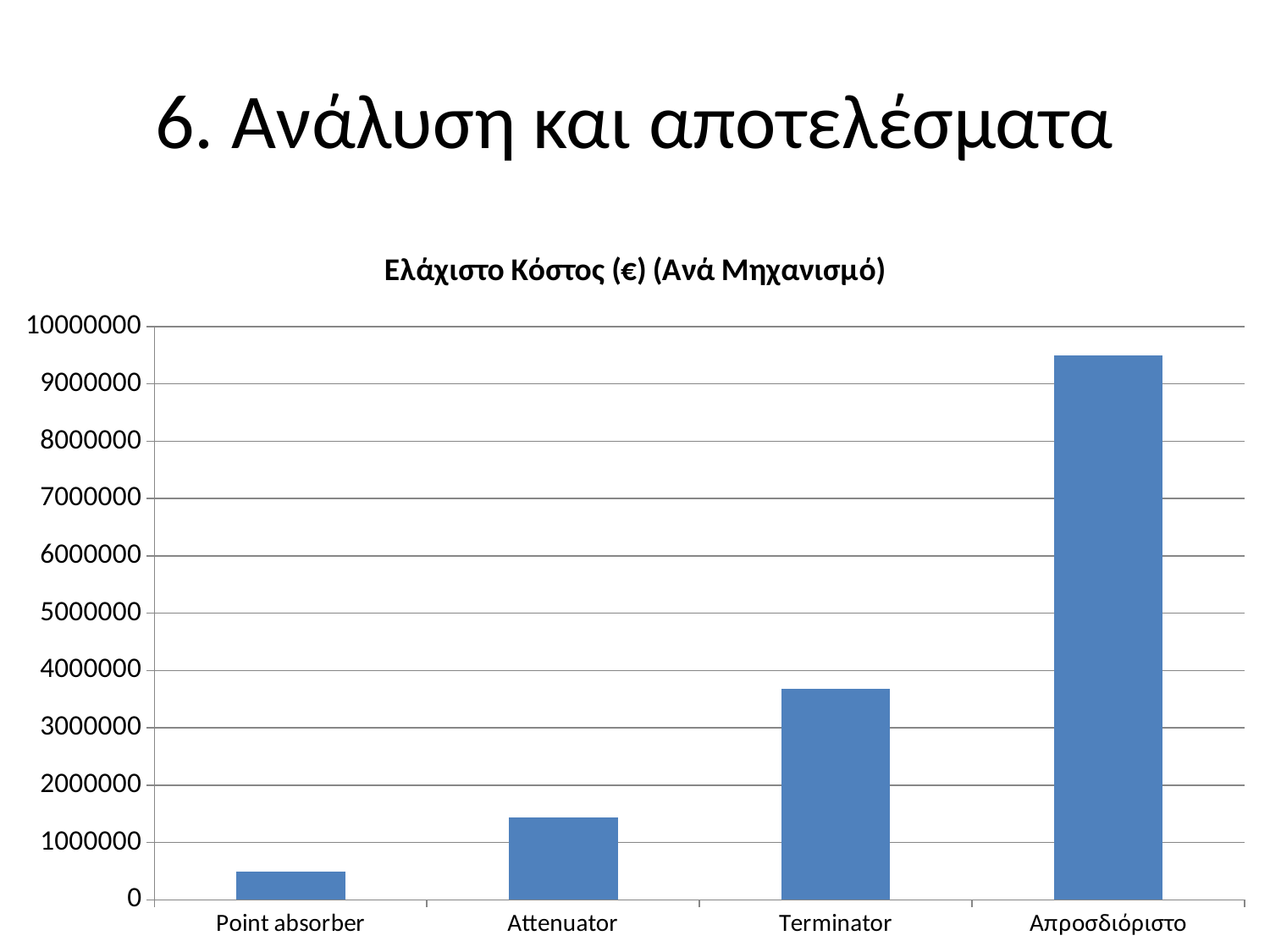
Which has a larger value, Terminator or Attenuator? Terminator What is the maximum value shown on the y axis? 10000000 What is the title of the chart? Ελάχιστο Κόστος (€) (Ανά Μηχανισμό) How many categories are shown on the x axis of the chart? 4 Which category has the lowest minimum cost? Point absorber Is the value for Terminator greater or less than 3000000? greater Which category has the highest minimum cost? Απροσδιόριστο Is the value for Attenuator greater or less than 2000000? less Do the values rise or fall from left to right along the x axis? rise What type of chart is shown on the slide? bar chart Is the value for Απροσδιόριστο greater or less than 9000000? greater